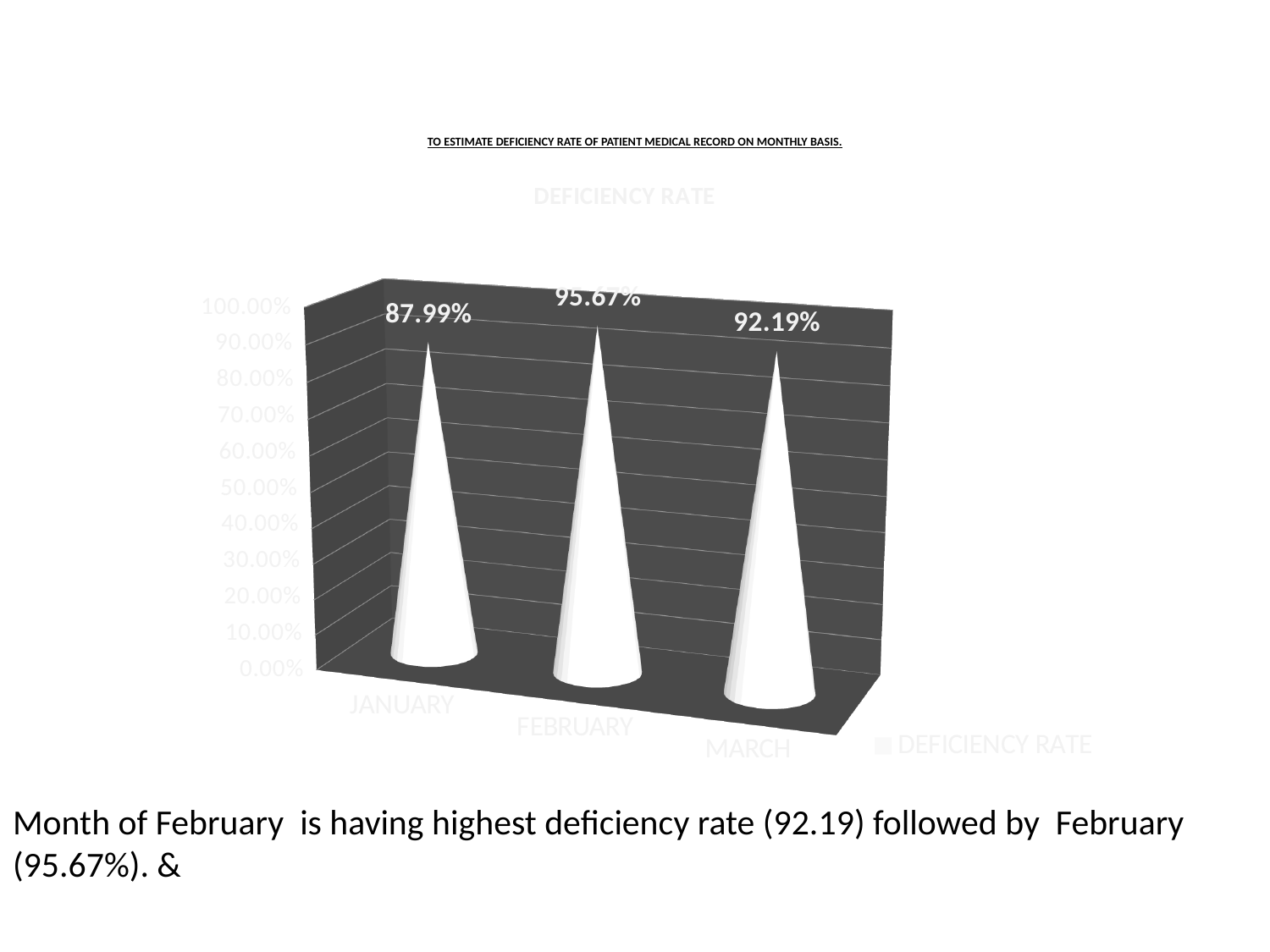
Which month has a higher deficiency rate, March or January? March What is the deficiency rate for January? 87.99% What kind of chart is shown on the slide? bar chart What is the deficiency rate for March? 92.19% What is the deficiency rate for February? 95.67% Which month has the lowest deficiency rate? January What is the difference between the deficiency rates for March and January? 4.20% How many months are shown on the chart? 3 How many series does the legend list? 1 Which month has the highest deficiency rate? February What is the difference between the deficiency rates for February and January? 7.68% Is the deficiency rate for January greater or less than 90.00%? less